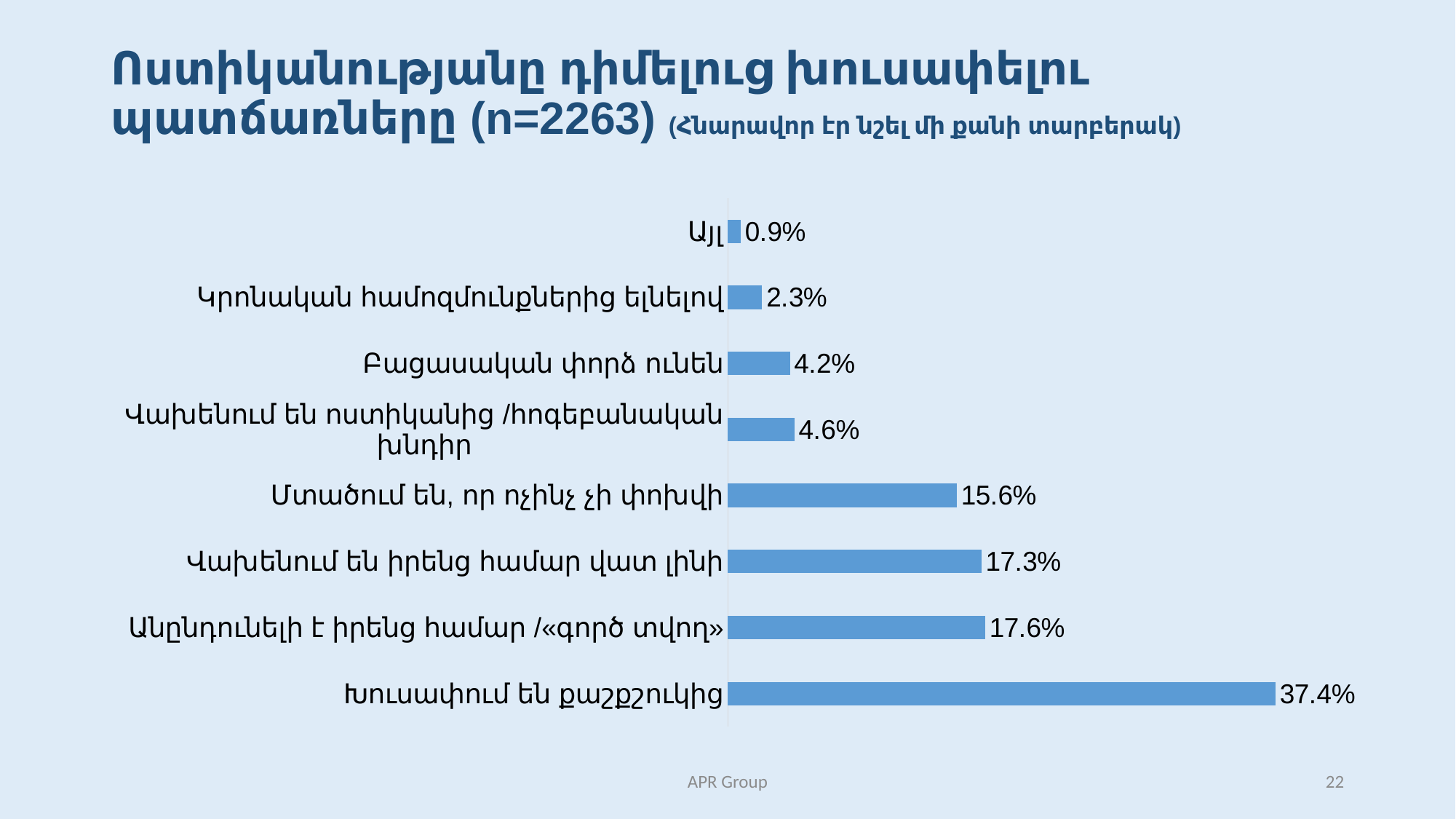
What sample size (n) is stated in the slide title? n=2263 How many categories does the bar chart show? 8 What kind of chart is shown on the slide? bar chart Which category has the highest value? Խուսափում են քաշքշուկից What is the value for "Կրոնական համոզմունքներից ելնելով"? 2.3% What is the value for "Խուսափում են քաշքշուկից"? 37.4% Which category has the lowest value? Այլ What is the value for "Բացասական փորձ ունեն"? 4.2% What is the value for "Այլ"? 0.9% What is the difference between "Խուսափում են քաշքշուկից" and "Անընդունելի է իրենց համար /«գործ տվող»"? 19.8% What is the value for "Մտածում են, որ ոչինչ չի փոխվի"? 15.6% Which is larger: "Վախենում են ոստիկանից /հոգեբանական խնդիր" or "Բացասական փորձ ունեն"? Վախենում են ոստիկանից /հոգեբանական խնդիր